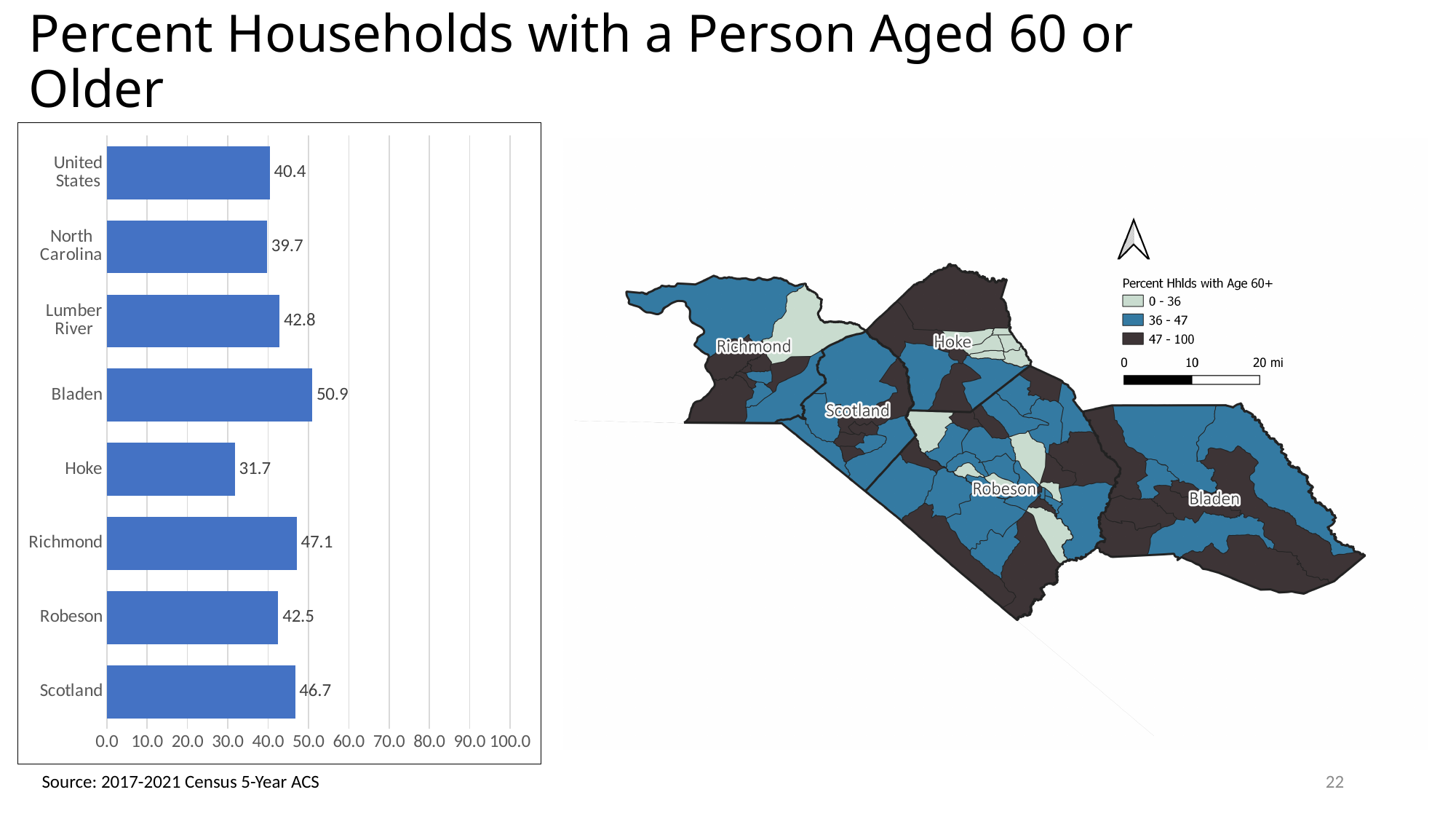
What is the difference between the values for Richmond and Scotland in the bar chart? 0.4 What is the value for North Carolina in the bar chart? 39.7 What kind of chart is shown on the left of the slide? Bar chart What is the highest value shown on the x axis of the bar chart? 100.0 What is the value for Hoke in the bar chart? 31.7 What is the value for Bladen in the bar chart? 50.9 Which category has the lowest value in the bar chart? Hoke Which category has the highest value in the bar chart? Bladen How many categories are shown in the bar chart? 8 Which is larger in the bar chart, the value for Robeson or the value for Richmond? Richmond What is the difference between the values for Bladen and Hoke in the bar chart? 19.2 What is the value for Lumber River in the bar chart? 42.8